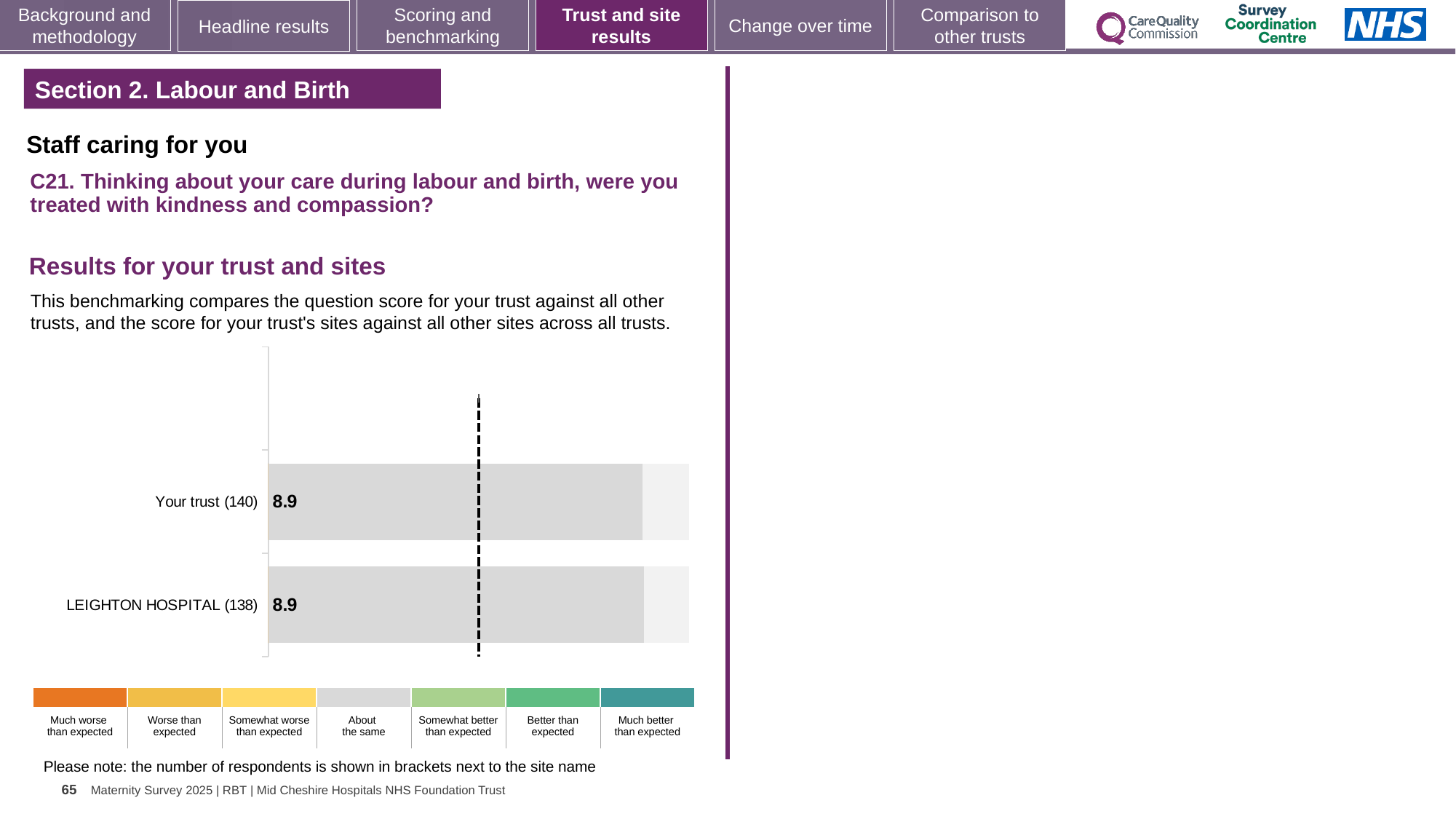
What is the score for Your trust? 8.9 What is the difference between the score for Your trust and the score for LEIGHTON HOSPITAL? 0 Is the score for Your trust the same as the score for LEIGHTON HOSPITAL? Yes How many benchmark categories are shown in the colour key below the chart? 7 How many respondents are shown in brackets for Your trust? 140 Which survey question does the chart relate to? C21. Thinking about your care during labour and birth, were you treated with kindness and compassion? What kind of chart is shown on the slide? Bar chart How many respondents are shown in brackets for LEIGHTON HOSPITAL? 138 How many bars are plotted in the chart? 2 What is the score for LEIGHTON HOSPITAL? 8.9